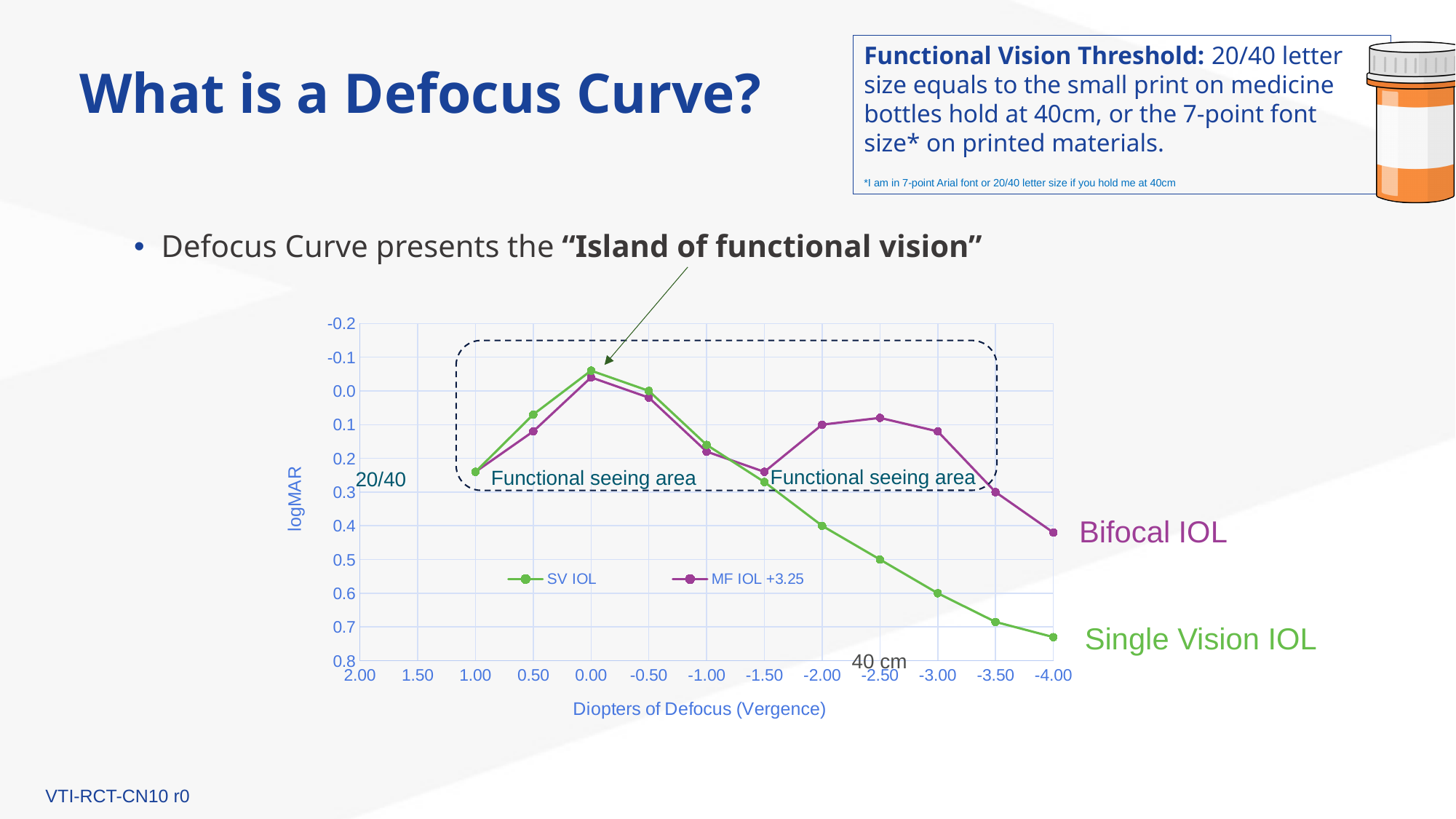
What is the logMAR value for SV IOL at -2.00 diopters of defocus? 0.4 How many series does the chart legend list? 2 What is the title of the x axis of the chart? Diopters of Defocus (Vergence) Is the logMAR value for SV IOL at -4.00 diopters of defocus greater or less than 0.7? greater What is the logMAR value for MF IOL +3.25 at -2.00 diopters of defocus? 0.1 What are the two series named in the chart legend? SV IOL and MF IOL +3.25 At which diopters of defocus does the SV IOL series reach its lowest logMAR value? 0.00 What type of chart is shown on the slide? line chart At -2.50 diopters of defocus, which series has the higher logMAR value, SV IOL or MF IOL +3.25? SV IOL What is the difference between the SV IOL logMAR values at -3.00 and -2.00 diopters of defocus? 0.2 What is the logMAR value for SV IOL at -3.00 diopters of defocus? 0.6 What is the logMAR value for MF IOL +3.25 at -3.50 diopters of defocus? 0.3